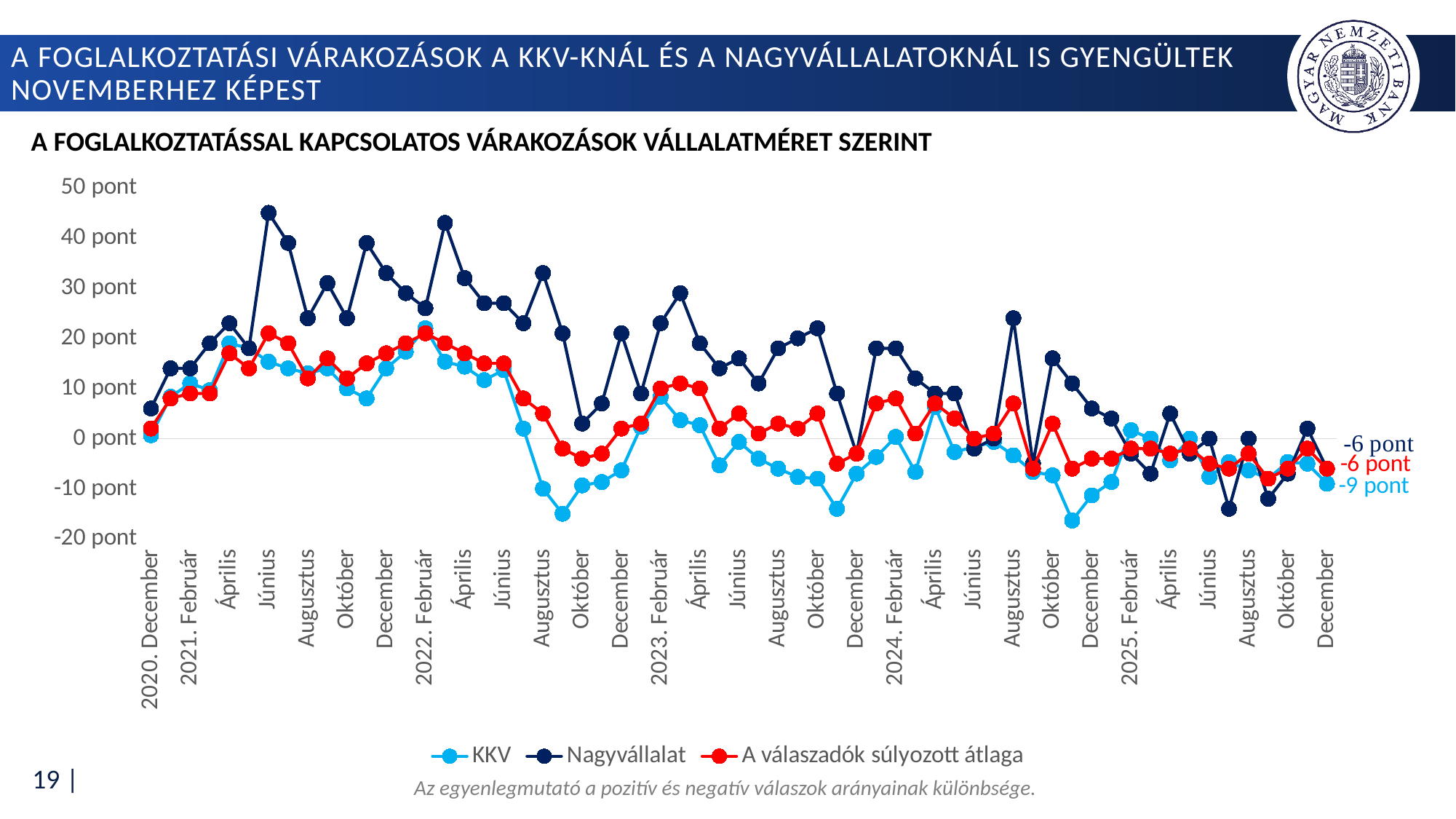
What is the value of 'A válaszadók súlyozott átlaga' in 2025 December? -6 pont Which series has the lowest value in 2025 December? KKV What is the difference between the Nagyvállalat and KKV values in 2025 December? 3 pont In 2025 December, which is larger: the KKV value or the Nagyvállalat value? Nagyvállalat How many series does the legend list? 3 What is the title of the chart? A FOGLALKOZTATÁSSAL KAPCSOLATOS VÁRAKOZÁSOK VÁLLALATMÉRET SZERINT What is the value of the KKV series in 2025 December? -9 pont Is the value for Nagyvállalat in 2021 Június greater or less than 40 pont? greater Which series reaches the highest point anywhere on the chart? Nagyvállalat What is the value of the Nagyvállalat series in 2025 December? -6 pont What type of chart is shown on the slide? line chart